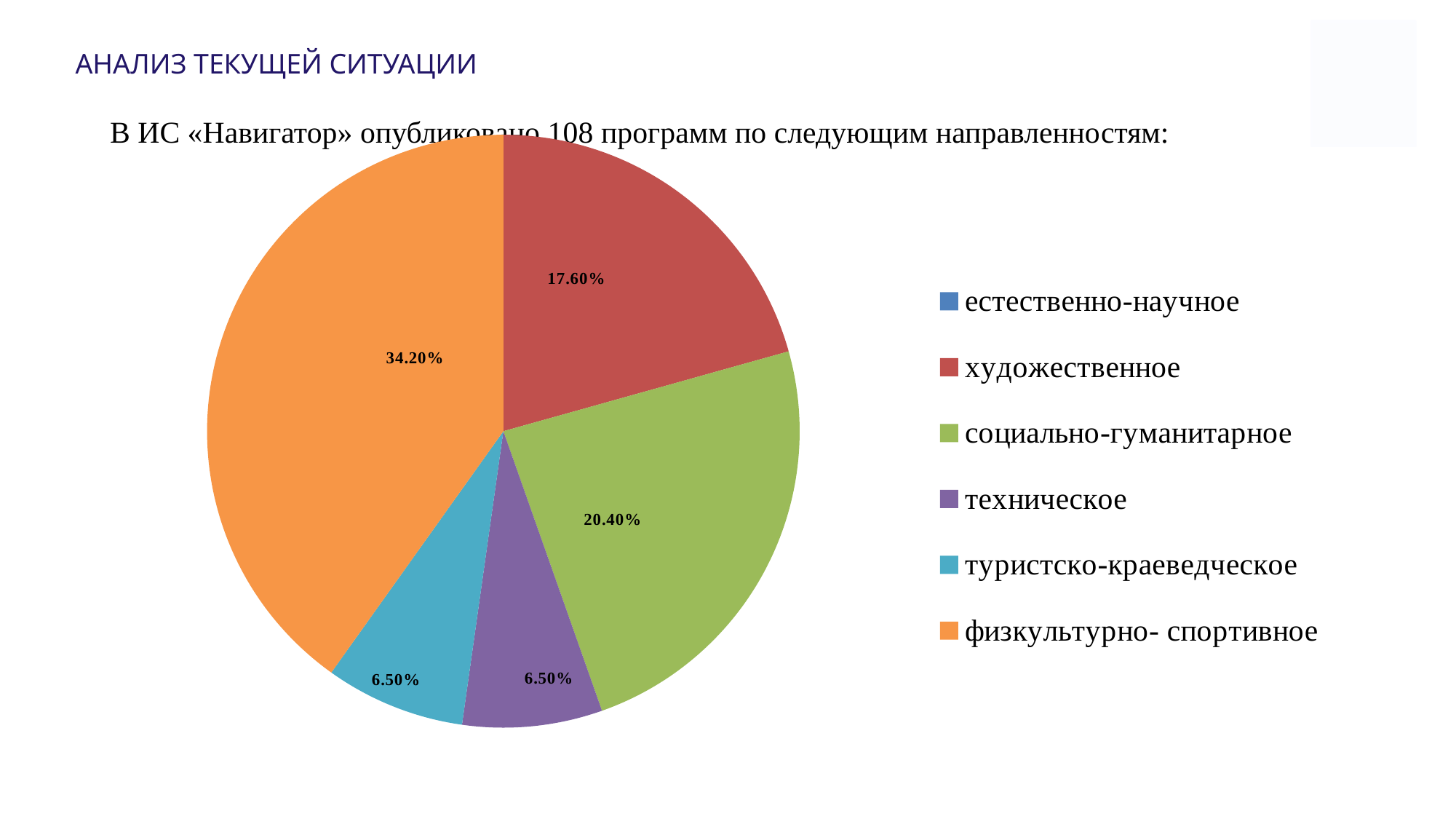
What percentage is shown for туристско-краеведческое? 6.50% How many percentage points larger is физкультурно- спортивное than социально-гуманитарное? 13.80% What kind of chart is shown on the slide? pie chart What colour is the физкультурно- спортивное slice? orange How many categories does the legend list? 6 What is the value labelled on the социально-гуманитарное slice? 20.40% Which category has the largest slice of the pie? физкультурно- спортивное What share does the художественное slice have? 17.60% What is the difference between the социально-гуманитарное and художественное shares? 2.80% What percentage of programs is shown for физкультурно- спортивное? 34.20% What percentage is shown for техническое? 6.50% Which is larger, the художественное slice or the социально-гуманитарное slice? социально-гуманитарное